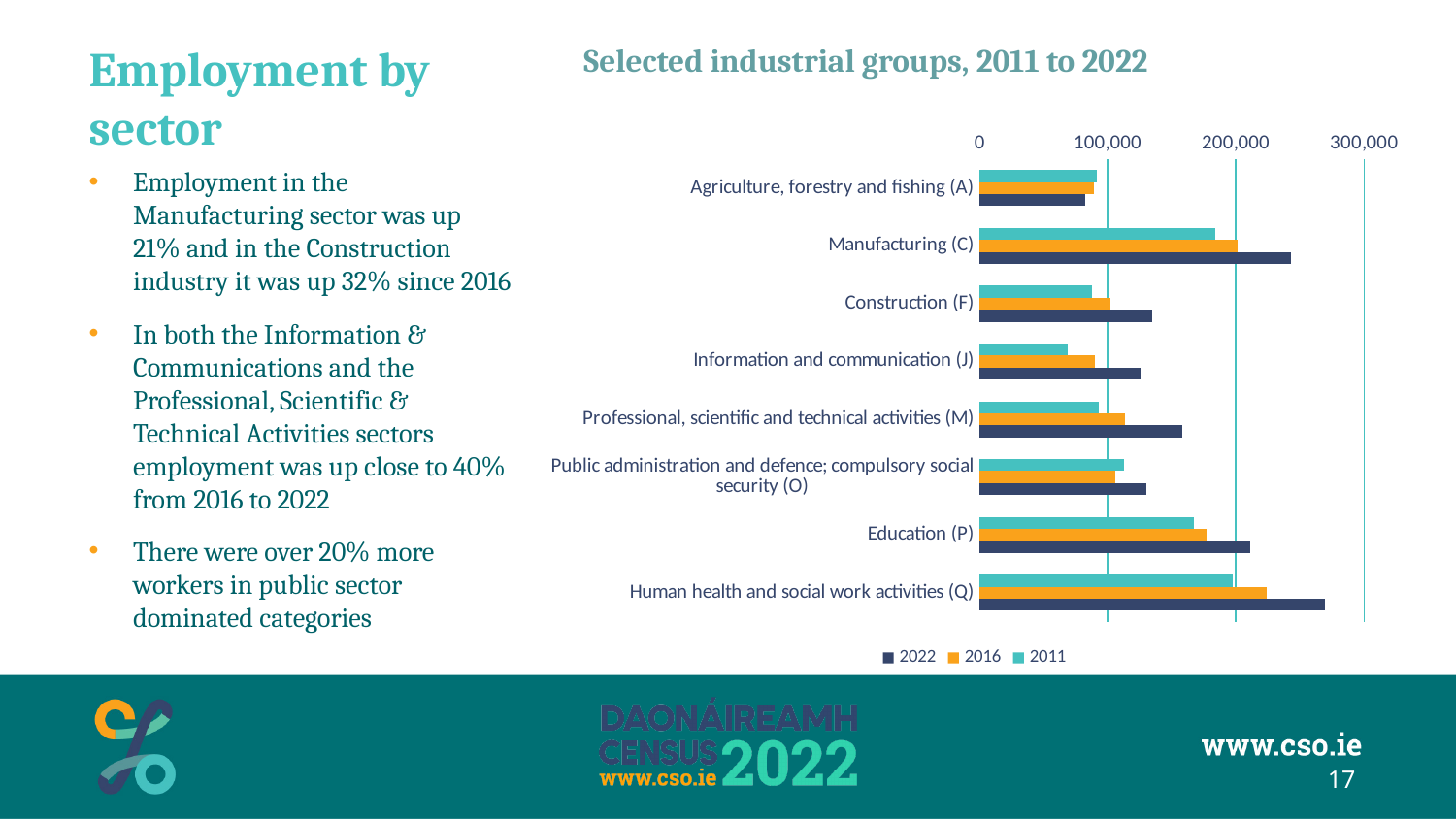
For Information and communication (J), do the values rise or fall from 2011 to 2016 to 2022? rise What kind of chart is shown on the slide? Bar chart Which industrial group has the lowest 2022 employment value? Agriculture, forestry and fishing (A) Which years are listed in the chart's legend? 2022, 2016 and 2011 Which industrial group has the highest 2022 employment value? Human health and social work activities (Q) What is the title of the chart? Selected industrial groups, 2011 to 2022 How many industrial groups are shown on the chart? 8 How many series does the chart's legend list? 3 Which is larger for 2022: Manufacturing (C) or Education (P)? Manufacturing (C) Is the 2011 value for Information and communication (J) greater or less than 100,000? less Is the 2022 value for Manufacturing (C) greater or less than 200,000? greater Is the 2022 value for Agriculture, forestry and fishing (A) greater or less than 100,000? less